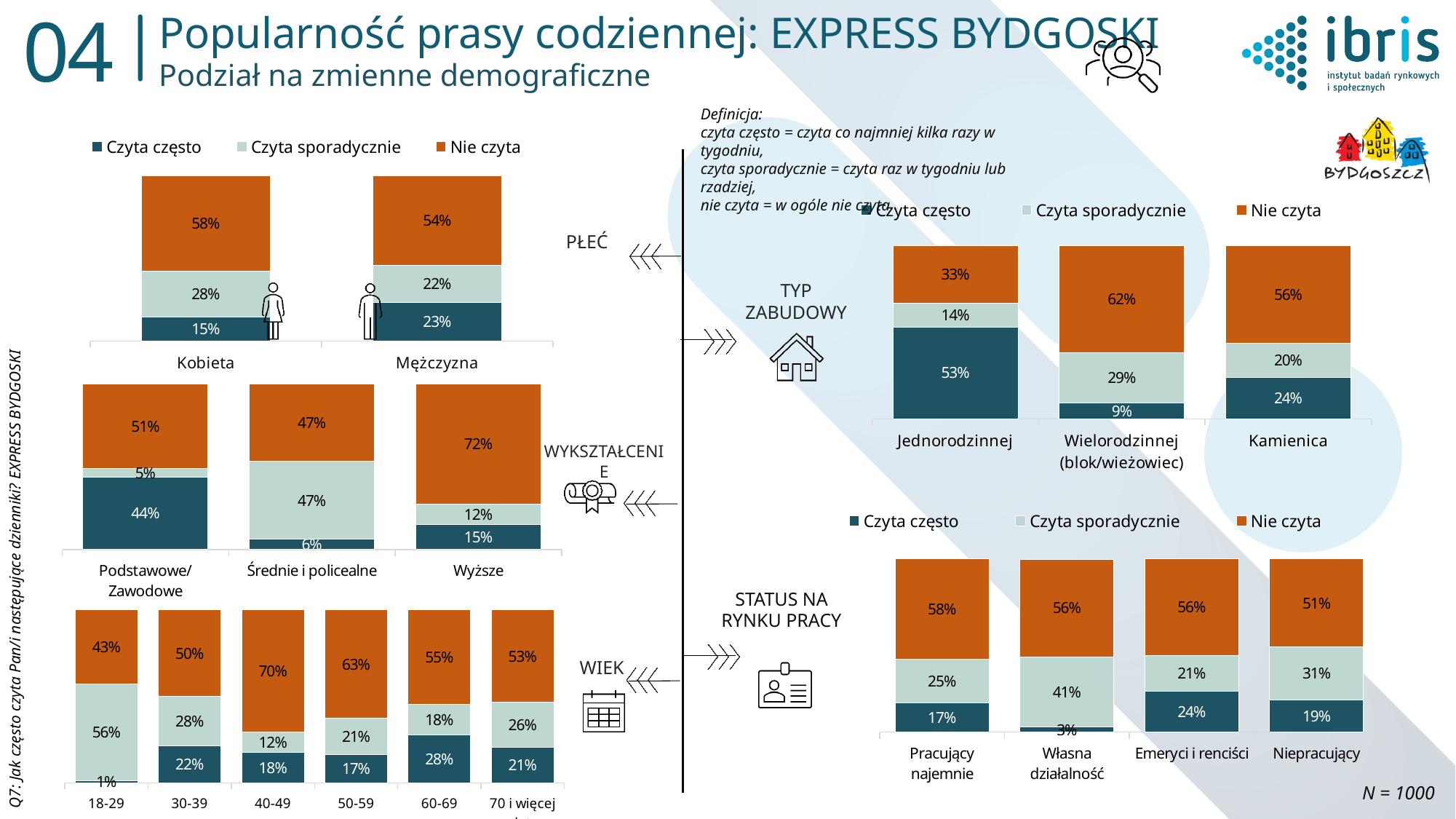
In the TYP ZABUDOWY chart, what is the difference between the 'Nie czyta' values for Wielorodzinnej (blok/wieżowiec) and Jednorodzinnej? 29 percentage points In the PŁEĆ chart, what percentage of Kobieta is 'Nie czyta'? 58% In the WIEK chart, what is the 'Czyta sporadycznie' value for 18-29? 56% In the STATUS NA RYNKU PRACY chart, is the 'Czyta sporadycznie' value larger for Niepracujący or for Emeryci i renciści? Niepracujący In the WYKSZTAŁCENIE chart, which category has the highest 'Czyta często' value? Podstawowe/Zawodowe In the WIEK chart, how many age groups are shown? 6 In the PŁEĆ chart, what percentage of Mężczyzna is 'Czyta często'? 23% In the WIEK chart, which age group has the highest 'Nie czyta' value? 40-49 In the WYKSZTAŁCENIE chart, what is the 'Nie czyta' value for Wyższe? 72% In the TYP ZABUDOWY chart, what is the 'Czyta często' value for Jednorodzinnej? 53% In the STATUS NA RYNKU PRACY chart, which category has the lowest 'Czyta często' value? Własna działalność How many series does the legend of the PŁEĆ chart list? 3